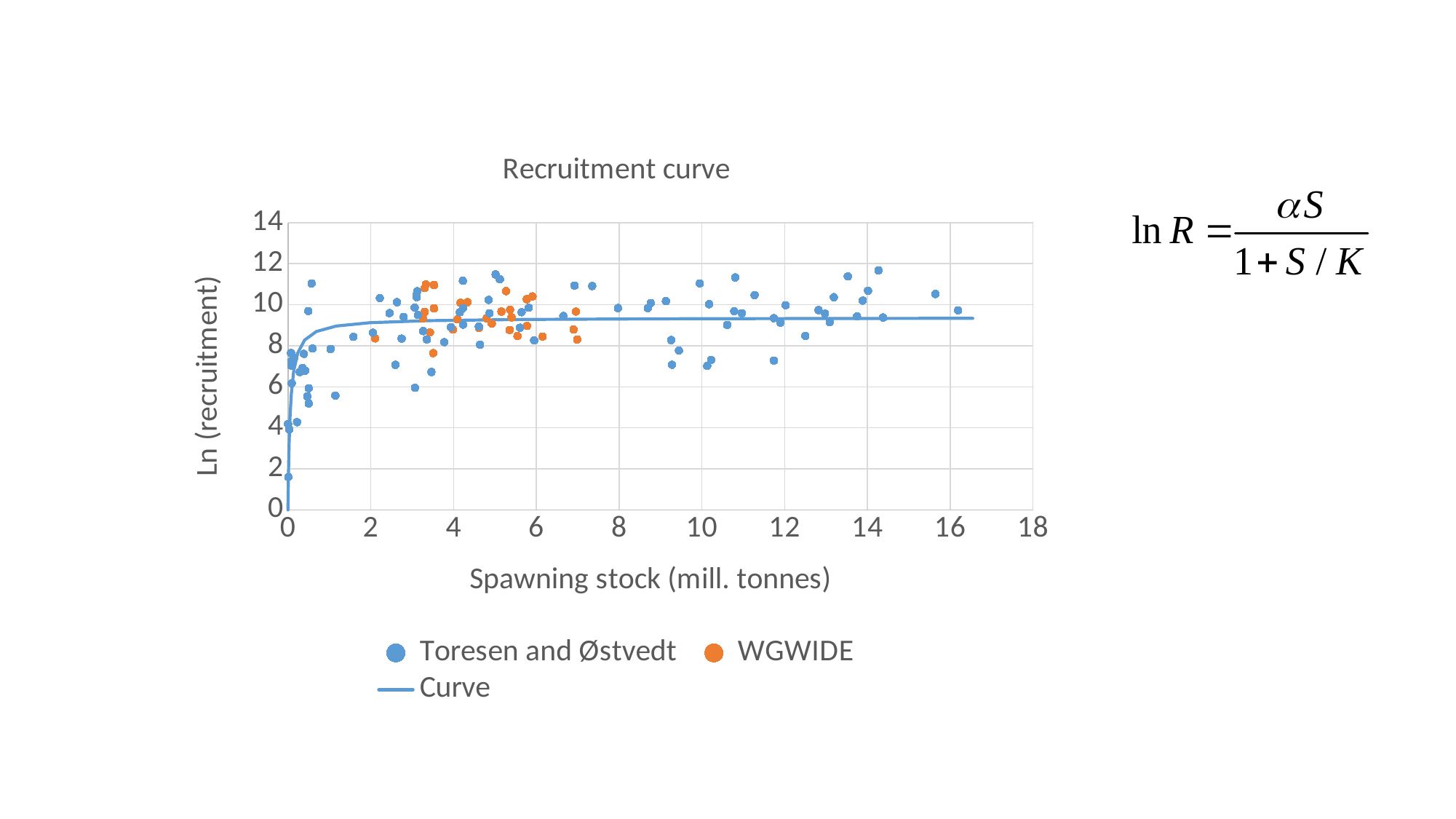
Is the value of the Curve series at a spawning stock of 10 greater or less than 8? greater What is the title of the chart? Recruitment curve What is the highest tick value shown on the x axis? 18 What is the label of the x axis? Spawning stock (mill. tonnes) What is the highest tick value shown on the y axis? 14 Is the value of the Curve series at a spawning stock of 16 greater or less than 10? less What kind of chart is shown on the slide? Scatter chart Is the value of the Curve series at a spawning stock of 4 greater or less than 12? less Which series is plotted with orange markers? WGWIDE Does the Curve series rise or fall as spawning stock increases from 0 to 2? rise How many series does the legend list? 3